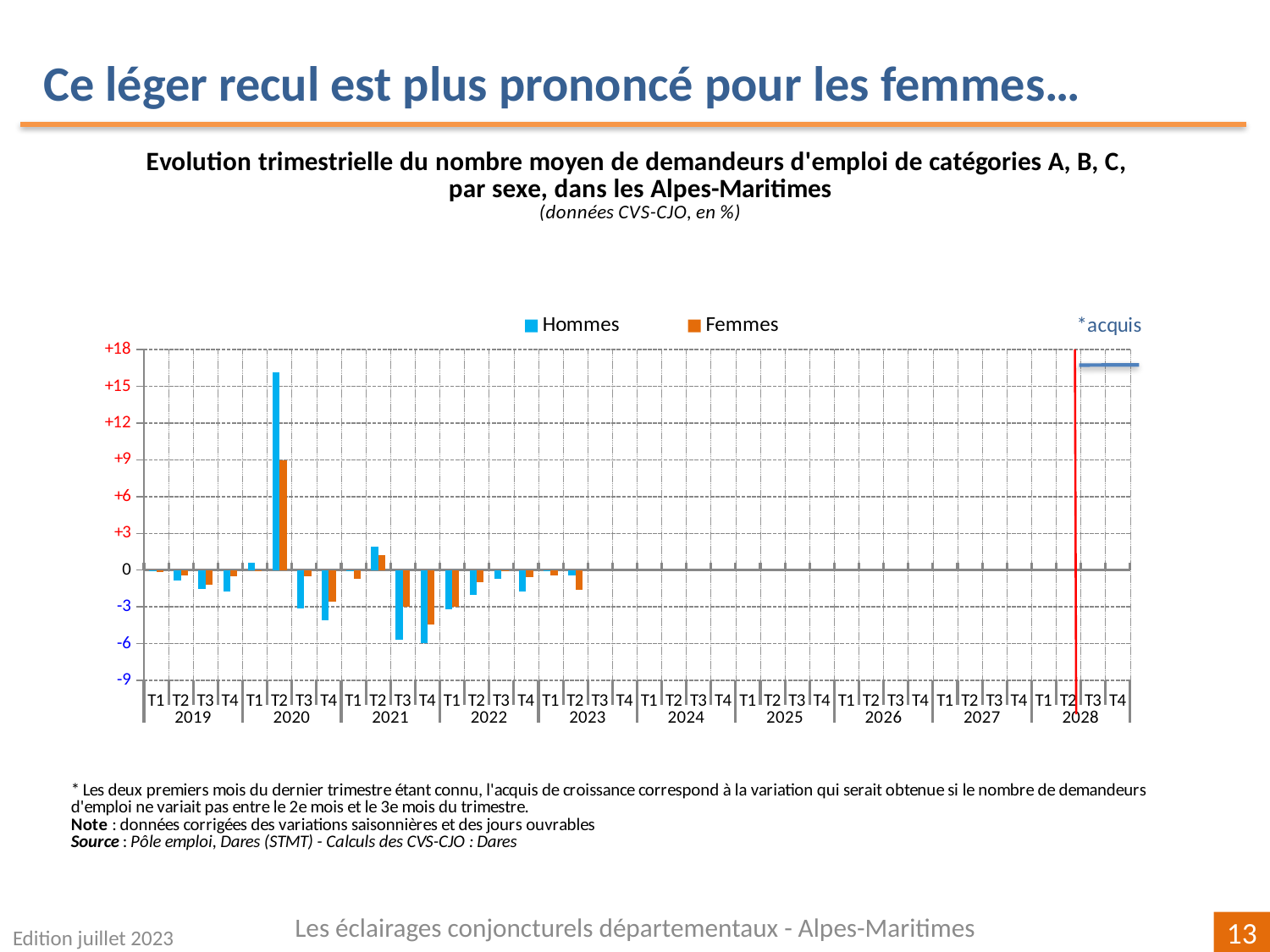
What kind of chart is shown on the slide? bar chart In T3 2021, which series has the lower value, Hommes or Femmes? Hommes In which quarter does the Femmes series reach its highest value? T2 2020 Is the value for Hommes in T4 2021 greater or less than -3? less In which quarter does the Hommes series reach its highest value? T2 2020 Which series is shown in orange? Femmes Is the value for Femmes in T4 2021 greater or less than -3? less Is the value for Femmes in T2 2020 greater or less than +6? greater How many years are labelled along the x axis? 10 In T2 2020, which series has the larger value, Hommes or Femmes? Hommes How many series does the legend list? 2